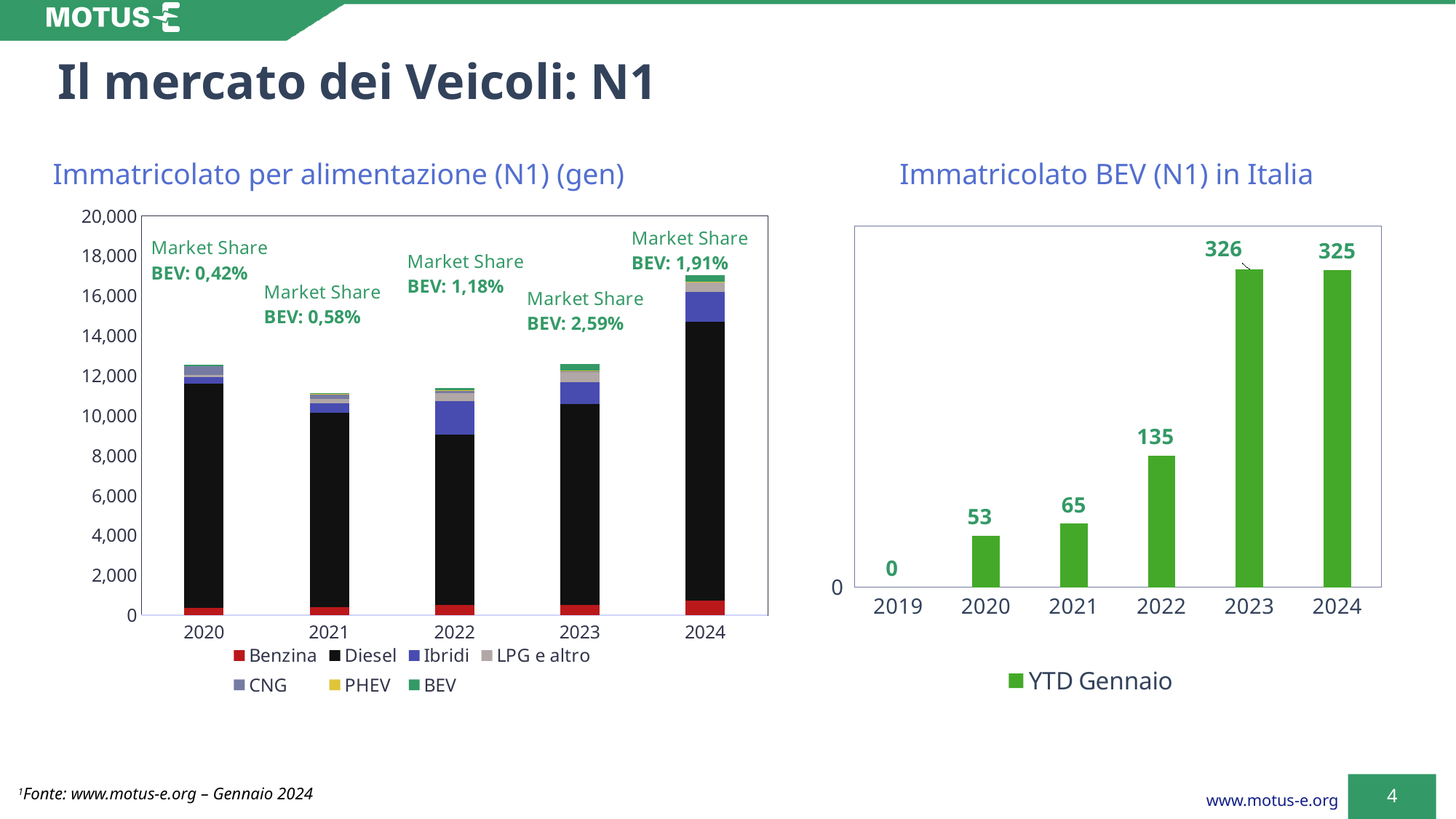
In the chart 'Immatricolato BEV (N1) in Italia', what is the difference between the 2023 and 2022 values? 191 In the chart 'Immatricolato per alimentazione (N1) (gen)', how many series does the legend list? 7 In the chart 'Immatricolato BEV (N1) in Italia', which year has the highest value? 2023 In the chart 'Immatricolato per alimentazione (N1) (gen)', what is the BEV market share shown for 2023? 2,59% In the chart 'Immatricolato per alimentazione (N1) (gen)', is the total stacked bar for 2021 greater or less than 12,000? less In the chart 'Immatricolato BEV (N1) in Italia', do the values rise or fall from 2019 to 2023? Rise In the chart 'Immatricolato BEV (N1) in Italia', what is the value for 2020? 53 What kind of chart is 'Immatricolato BEV (N1) in Italia'? Bar chart In the chart 'Immatricolato per alimentazione (N1) (gen)', is the total stacked bar for 2024 greater or less than 16,000? greater In the chart 'Immatricolato per alimentazione (N1) (gen)', which year has the lowest BEV market share annotation? 2020 In the chart 'Immatricolato BEV (N1) in Italia', how many years are shown on the x axis? 6 In the chart 'Immatricolato BEV (N1) in Italia', what is the value for 2022? 135